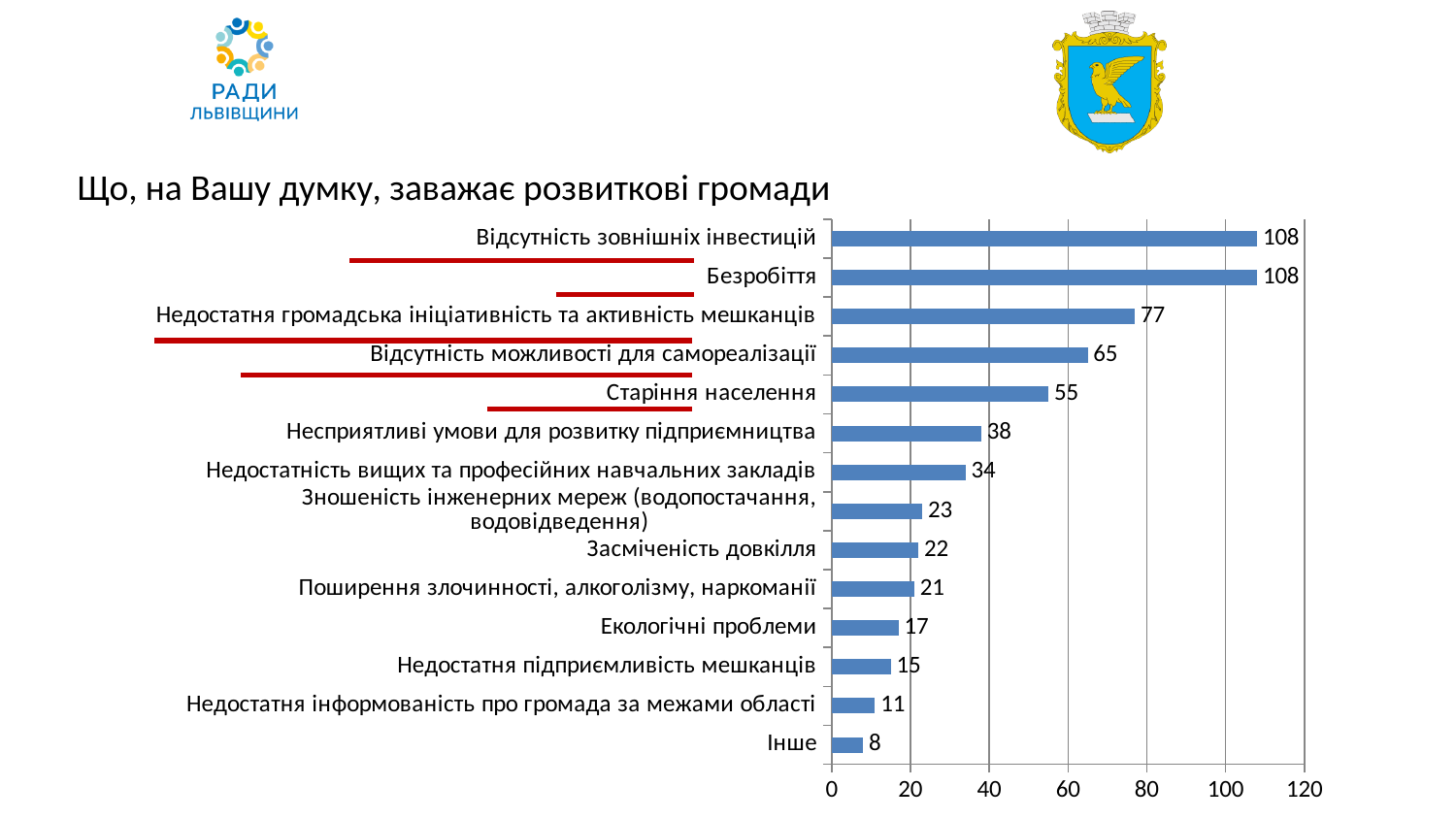
What kind of chart is shown on the slide? bar chart What value is shown for "Безробіття"? 108 What value is shown for "Старіння населення"? 55 What is the difference between the values for "Недостатня громадська ініціативність та активність мешканців" and "Відсутність можливості для самореалізації"? 12 What value is shown for "Недостатня інформованість про громада за межами області"? 11 Which is larger: the value for "Несприятливі умови для розвитку підприємництва" or the value for "Недостатність вищих та професійних навчальних закладів"? Несприятливі умови для розвитку підприємництва What is the difference between the values for "Засміченість довкілля" and "Інше"? 14 Is the value for "Відсутність зовнішніх інвестицій" greater or less than 100? greater What is the title of the chart? Що, на Вашу думку, заважає розвиткові громади How many categories are shown in the chart? 14 What value is shown for "Екологічні проблеми"? 17 Which category has the lowest value? Інше